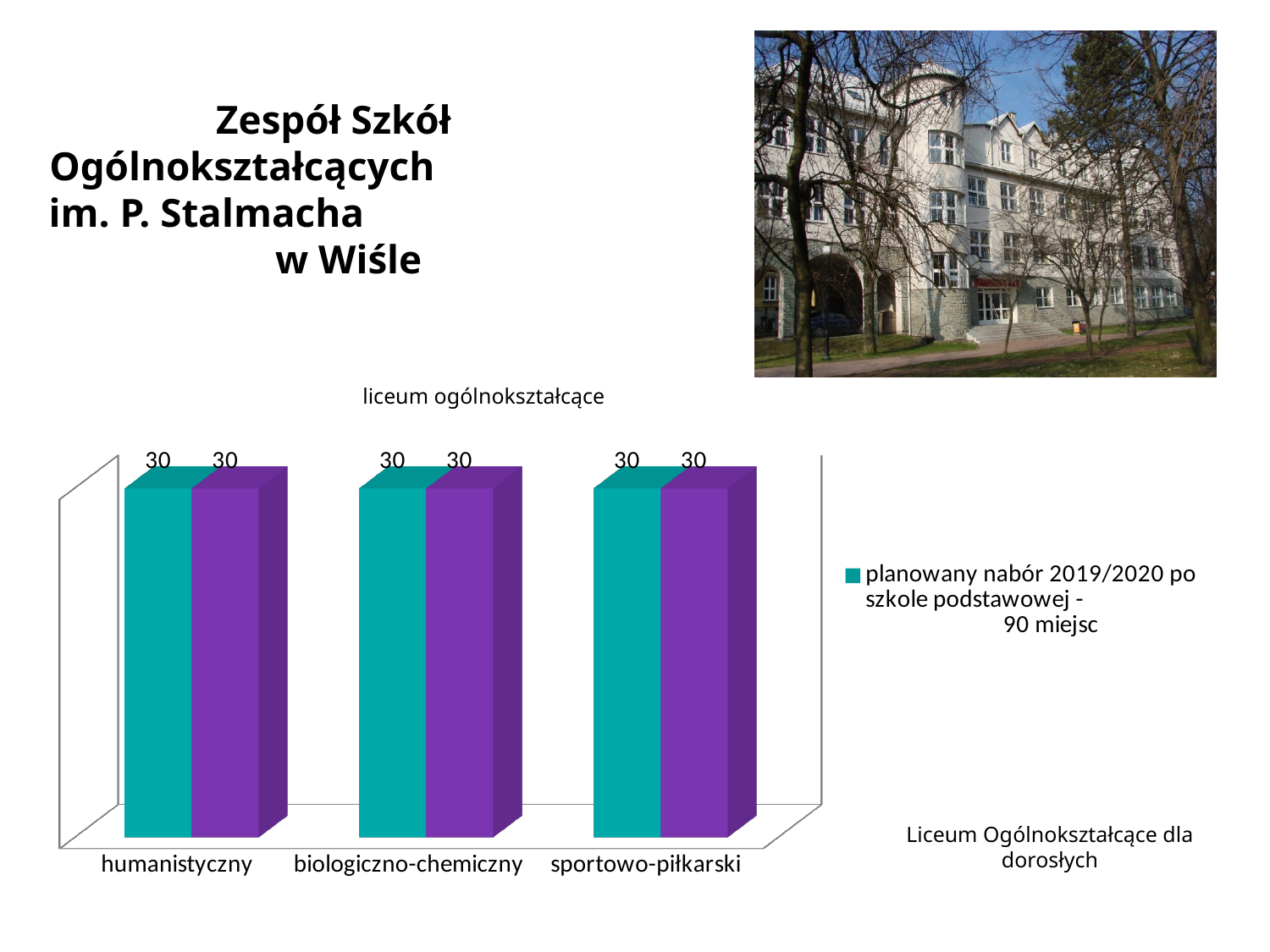
What is the value of the teal bar for sportowo-piłkarski? 30 What is the legend entry shown for the teal series? planowany nabór 2019/2020 po szkole podstawowej - 90 miejsc What kind of chart is shown on the slide? bar chart Which category is listed first on the x axis? humanistyczny How many categories are shown on the x axis of the chart? 3 What is the value of the teal bar for humanistyczny? 30 What is the difference between the teal bar for humanistyczny and the teal bar for sportowo-piłkarski? 0 Do the values rise, fall, or stay the same across the categories from humanistyczny to sportowo-piłkarski? stay the same What is the value of the purple bar for sportowo-piłkarski? 30 What is the title of the chart? liceum ogólnokształcące How many series does the legend list? 1 What is the value of the purple bar for biologiczno-chemiczny? 30